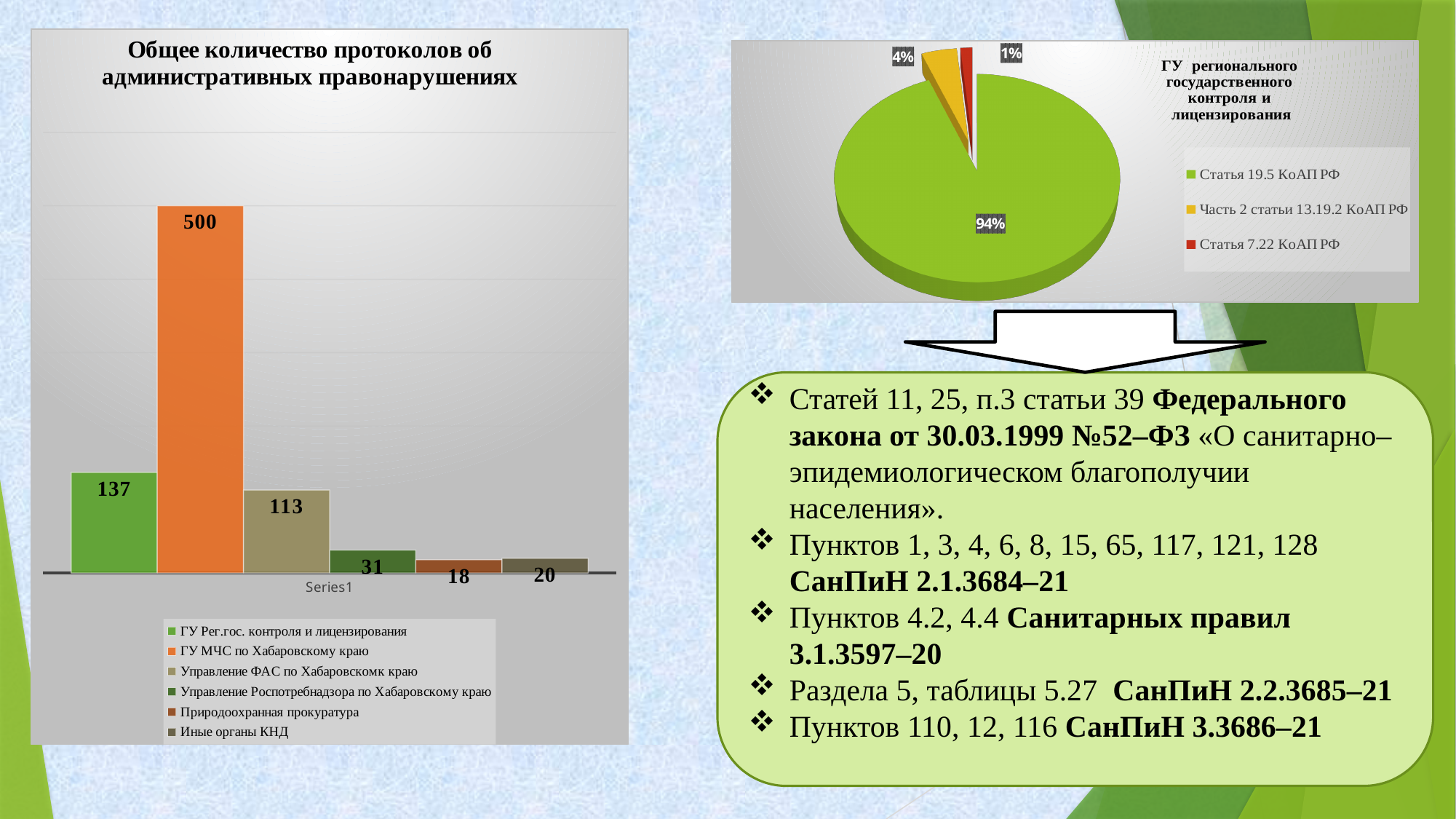
How many bars are shown in the bar chart 'Общее количество протоколов об административных правонарушениях'? 6 In the bar chart 'Общее количество протоколов об административных правонарушениях', which is larger: the value for Управление Роспотребнадзора по Хабаровскому краю or the value for Иные органы КНД? Управление Роспотребнадзора по Хабаровскому краю How many entries does the legend of the pie chart 'ГУ регионального государственного контроля и лицензирования' list? 3 In the pie chart 'ГУ регионального государственного контроля и лицензирования', what share does Часть 2 статьи 13.19.2 КоАП РФ have? 4% In the bar chart 'Общее количество протоколов об административных правонарушениях', what is the difference between the values for ГУ МЧС по Хабаровскому краю and ГУ Рег.гос. контроля и лицензирования? 363 In the bar chart 'Общее количество протоколов об административных правонарушениях', which category has the lowest value? Природоохранная прокуратура In the bar chart 'Общее количество протоколов об административных правонарушениях', which category has the highest value? ГУ МЧС по Хабаровскому краю In the pie chart 'ГУ регионального государственного контроля и лицензирования', what share does Статья 19.5 КоАП РФ have? 94% In the bar chart 'Общее количество протоколов об административных правонарушениях', what is the value for ГУ МЧС по Хабаровскому краю? 500 What type of chart is the chart on the left of the slide? Bar chart In the bar chart 'Общее количество протоколов об административных правонарушениях', what is the value for Природоохранная прокуратура? 18 In the bar chart 'Общее количество протоколов об административных правонарушениях', what is the value for Управление ФАС по Хабаровскомк краю? 113